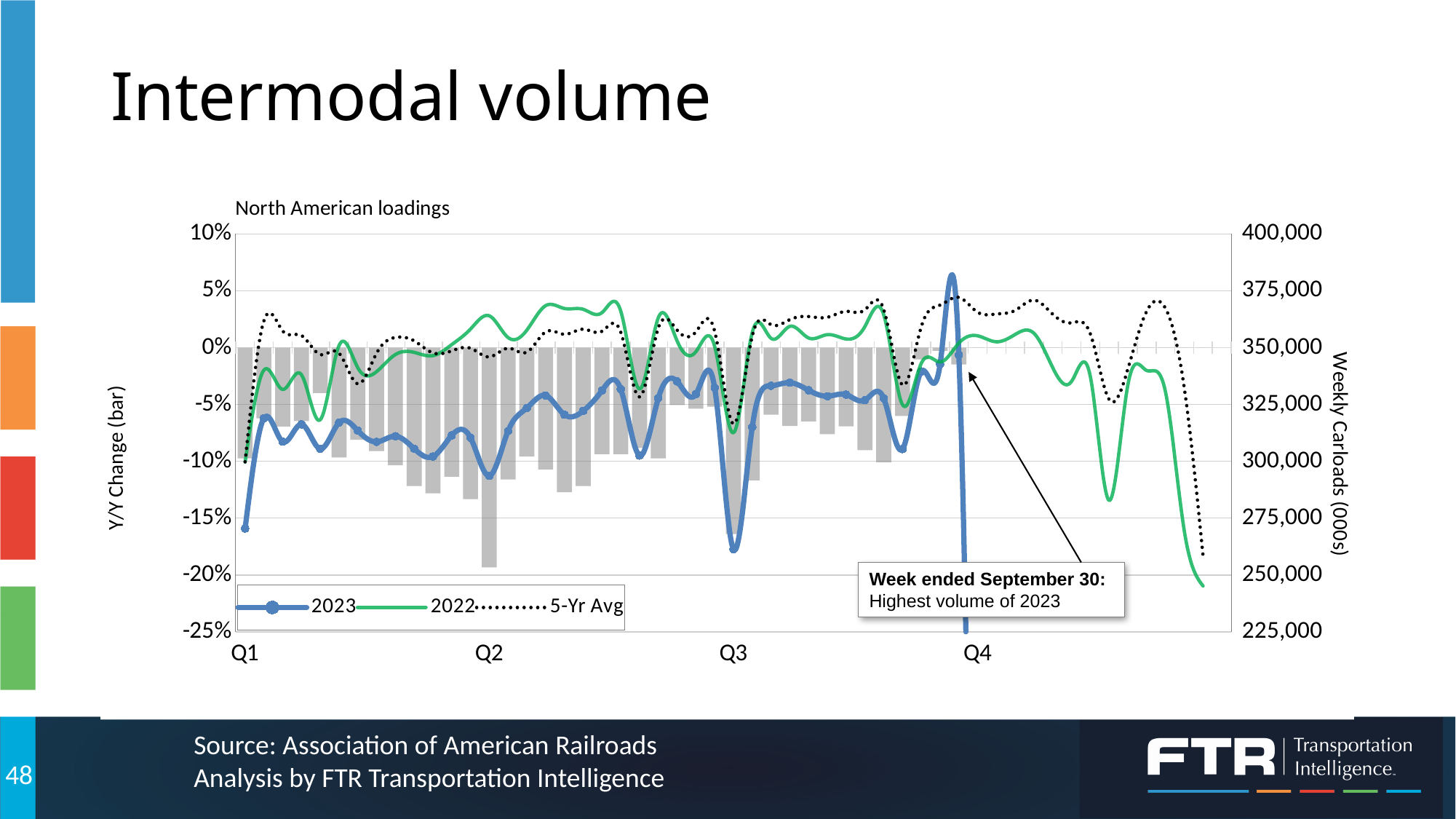
Does the 2022 line rise or fall over the final weeks of Q4? fall According to the annotation, which week had the highest volume of 2023? Week ended September 30 How many quarter labels are shown on the x axis? 4 Is the value of the 2023 line at the start of Q1 greater or less than 300,000? less What kind of chart is this? Combination bar and line chart Is the lowest gray Y/Y change bar (in Q2) greater or less than -15%? less What is the label of the right-hand vertical axis? Weekly Carloads (000s) Is the value of the 2022 line at the very end of the year greater or less than 250,000? less How many series does the chart legend list? 3 What is the title of the chart? North American loadings At the start of Q1, which line is higher: 2022 or 2023? 2022